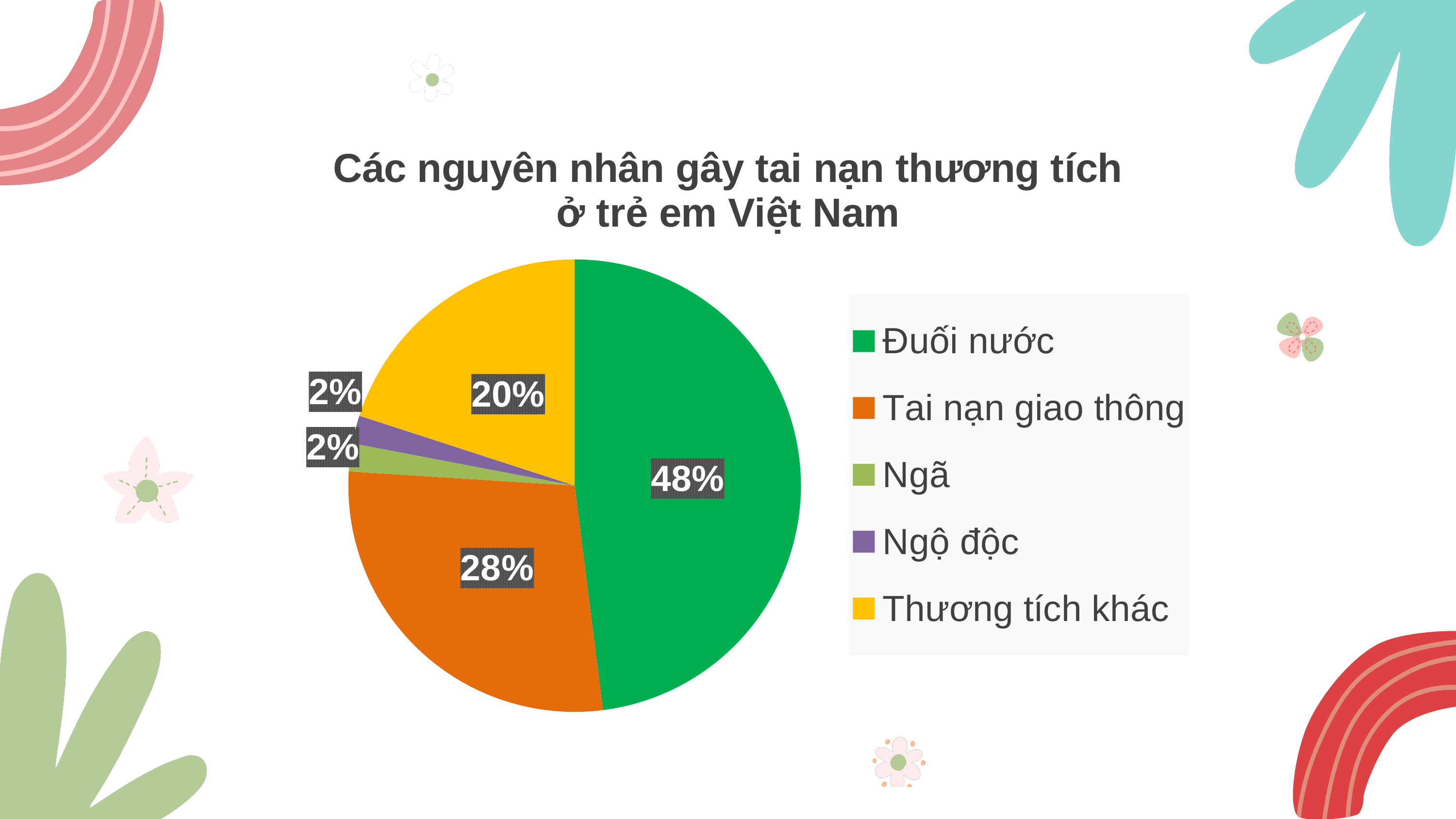
What colour is the slice for Thương tích khác? Yellow How many categories does the legend list? 5 What percentage of the pie is Ngã? 2% Which category has the largest share of the pie? Đuối nước What percentage of the pie is Ngộ độc? 2% What kind of chart is shown on the slide? Pie chart What percentage of the pie is Tai nạn giao thông? 28% What percentage of the pie is Thương tích khác? 20% What is the title of the chart? Các nguyên nhân gây tai nạn thương tích ở trẻ em Việt Nam What percentage of the pie is Đuối nước? 48% What is the difference between the shares of Đuối nước and Tai nạn giao thông? 20% Which is larger, the share of Tai nạn giao thông or the share of Thương tích khác? Tai nạn giao thông